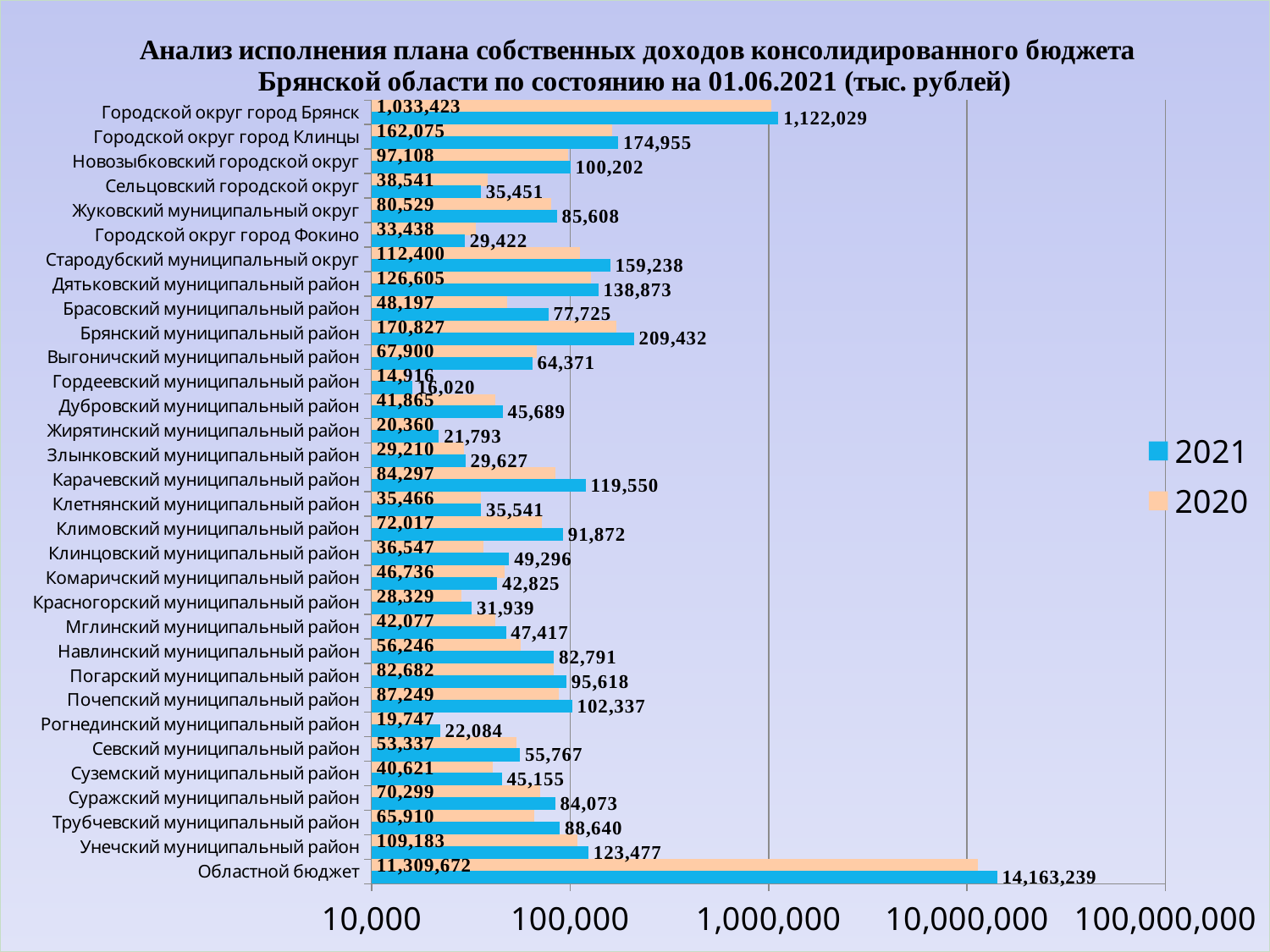
How many categories are shown on the chart? 32 Which is larger for Сельцовский городской округ: the 2021 value or the 2020 value? 2020 Which category has the highest 2021 value? Областной бюджет Which category has the lowest 2020 value? Гордеевский муниципальный район What is the difference between the 2021 and 2020 values for Городской округ город Клинцы? 12,880 Is the 2021 value for Унечский муниципальный район greater or less than 100,000? greater How many series does the legend list? 2 What is the 2020 value for Карачевский муниципальный район? 84,297 What is the 2021 value for Городской округ город Брянск? 1,122,029 What is the 2020 value for Областной бюджет? 11,309,672 What kind of chart is shown on the slide? Bar chart What is the 2021 value for Брянский муниципальный район? 209,432